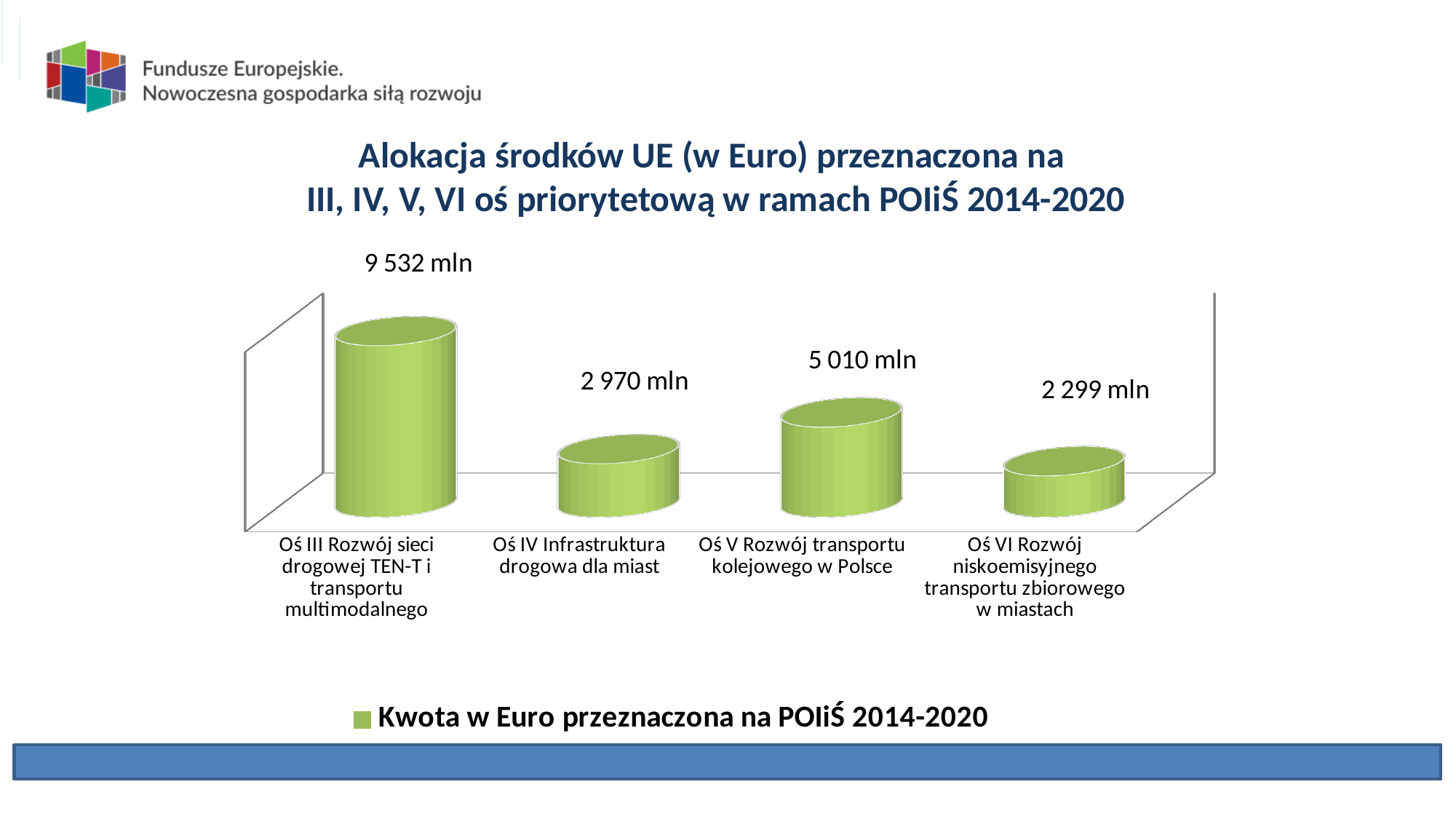
What is the value for Oś VI Rozwój niskoemisyjnego transportu zbiorowego w miastach? 2 299 mln What kind of chart is shown on the slide? Bar chart Which category has the highest value? Oś III Rozwój sieci drogowej TEN-T i transportu multimodalnego Which category has the lowest value? Oś VI Rozwój niskoemisyjnego transportu zbiorowego w miastach What is the difference between the values for Oś IV and Oś VI? 671 mln What is the value for Oś III Rozwój sieci drogowej TEN-T i transportu multimodalnego? 9 532 mln How many categories are shown in the chart? 4 What is the value for Oś IV Infrastruktura drogowa dla miast? 2 970 mln What is the difference between the values for Oś III and Oś V? 4 522 mln Which is larger, the value for Oś IV Infrastruktura drogowa dla miast or Oś V Rozwój transportu kolejowego w Polsce? Oś V Rozwój transportu kolejowego w Polsce What is the legend entry of the series shown in the chart? Kwota w Euro przeznaczona na POIiŚ 2014-2020 What is the value for Oś V Rozwój transportu kolejowego w Polsce? 5 010 mln